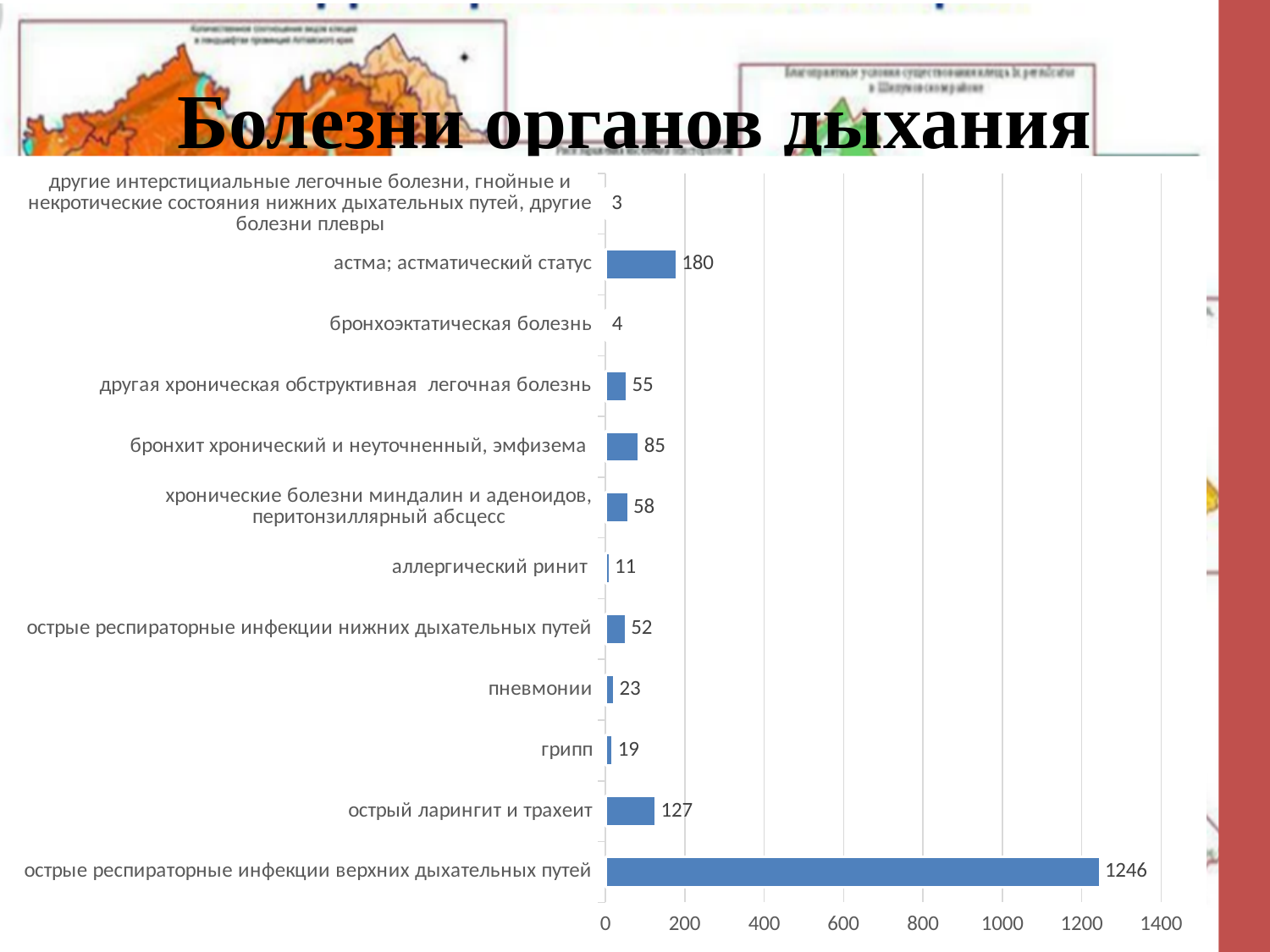
How many categories are shown in the chart? 12 What is the value for «острый ларингит и трахеит»? 127 What is the difference between the values for «пневмонии» and «грипп»? 4 What kind of chart is shown on the slide? bar chart What is the difference between the values for «острые респираторные инфекции верхних дыхательных путей» and «астма; астматический статус»? 1066 What is the value for «астма; астматический статус»? 180 What is the value for «бронхит хронический и неуточненный, эмфизема»? 85 What is the title of the slide? Болезни органов дыхания Which category has the highest value? острые респираторные инфекции верхних дыхательных путей Which is larger: the value for «аллергический ринит» or the value for «острые респираторные инфекции нижних дыхательных путей»? острые респираторные инфекции нижних дыхательных путей What is the value for «пневмонии»? 23 Which category has the lowest value? другие интерстициальные легочные болезни, гнойные и некротические состояния нижних дыхательных путей, другие болезни плевры